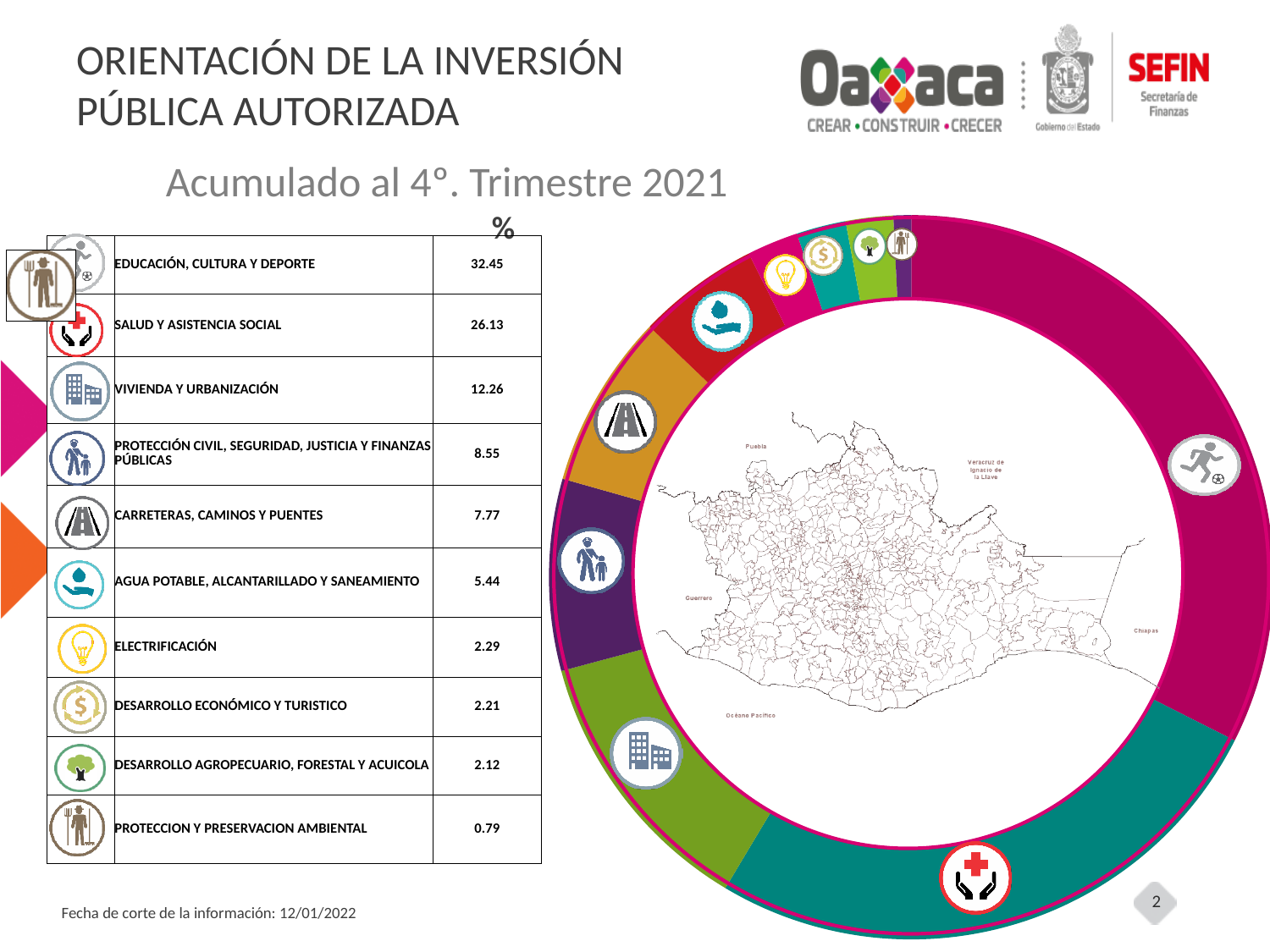
What is the difference in percentage points between ELECTRIFICACIÓN and DESARROLLO ECONÓMICO Y TURISTICO? 0.08 What is the difference in percentage points between EDUCACIÓN, CULTURA Y DEPORTE and SALUD Y ASISTENCIA SOCIAL? 6.32 What percentage is shown for EDUCACIÓN, CULTURA Y DEPORTE? 32.45 What percentage is shown for CARRETERAS, CAMINOS Y PUENTES? 7.77 Which is larger, the share for VIVIENDA Y URBANIZACIÓN or the share for CARRETERAS, CAMINOS Y PUENTES? VIVIENDA Y URBANIZACIÓN What percentage is shown for SALUD Y ASISTENCIA SOCIAL? 26.13 What is the subtitle above the chart indicating the period covered? Acumulado al 4°. Trimestre 2021 Which category has the largest share of the authorized public investment? EDUCACIÓN, CULTURA Y DEPORTE What percentage is shown for PROTECCION Y PRESERVACION AMBIENTAL? 0.79 What kind of chart is shown on the right of the slide? Doughnut chart Which category has the smallest share of the authorized public investment? PROTECCION Y PRESERVACION AMBIENTAL How many categories are listed in the table accompanying the doughnut chart? 10